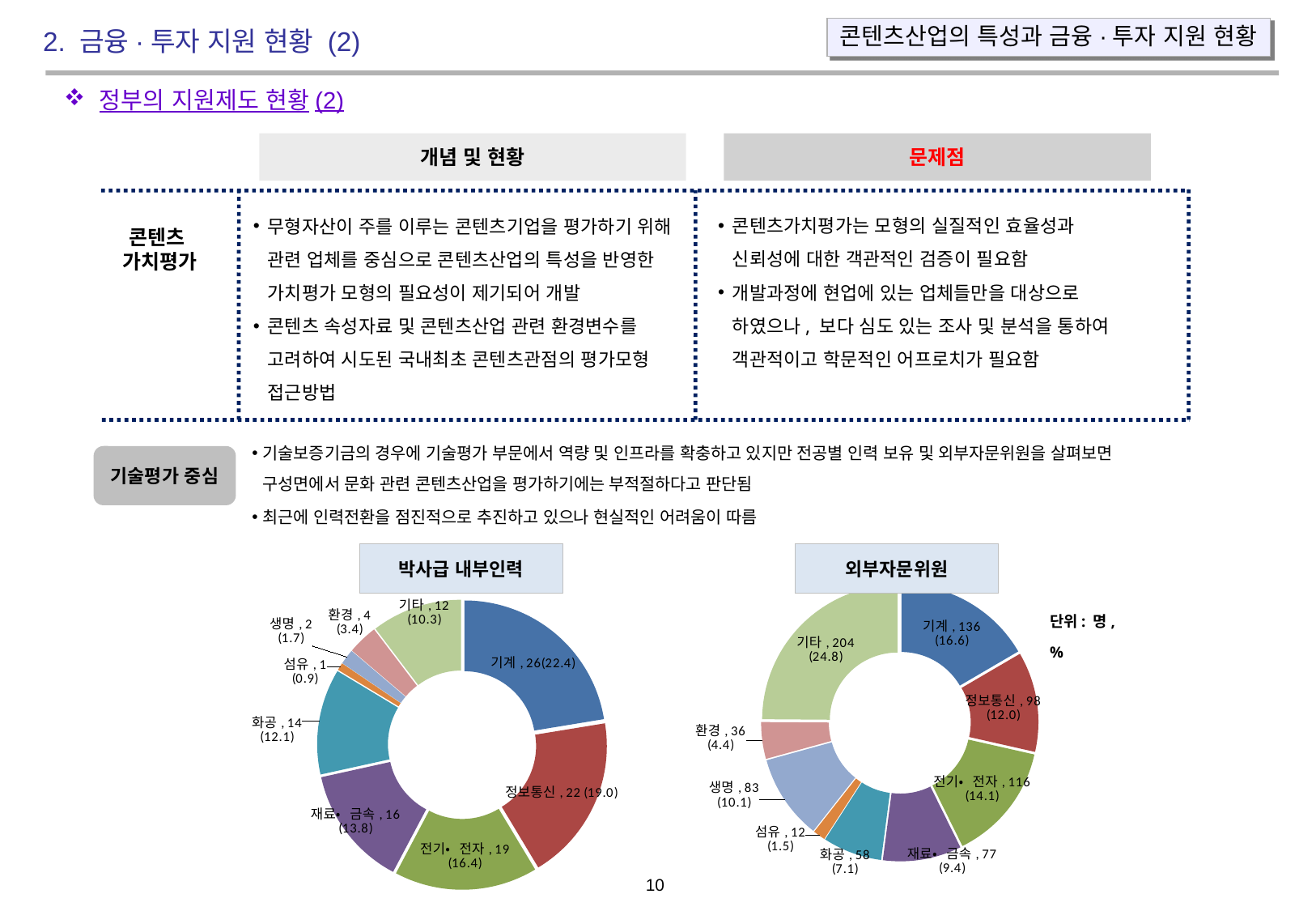
In the '박사급 내부인력' chart, which category has the highest value? 기계 In the '박사급 내부인력' chart, which category has the lowest value? 섬유 In the '외부자문위원' chart, what is the difference between the values for 기계 and 화공? 78 How many categories are shown in the '박사급 내부인력' chart? 9 In the '박사급 내부인력' chart, what is the difference between the values for 정보통신 and 전기·전자? 3 In the '외부자문위원' chart, what is the value for 기타? 204 In the '외부자문위원' chart, which category has the highest value? 기타 In the '외부자문위원' chart, which is larger, 정보통신 or 전기·전자? 전기·전자 In the '외부자문위원' chart, what percentage share is shown for 생명? 10.1 What type of chart is the '외부자문위원' chart? Doughnut chart In the '박사급 내부인력' chart, what percentage share is shown for 화공? 12.1 In the '박사급 내부인력' chart, what is the value for 기계? 26